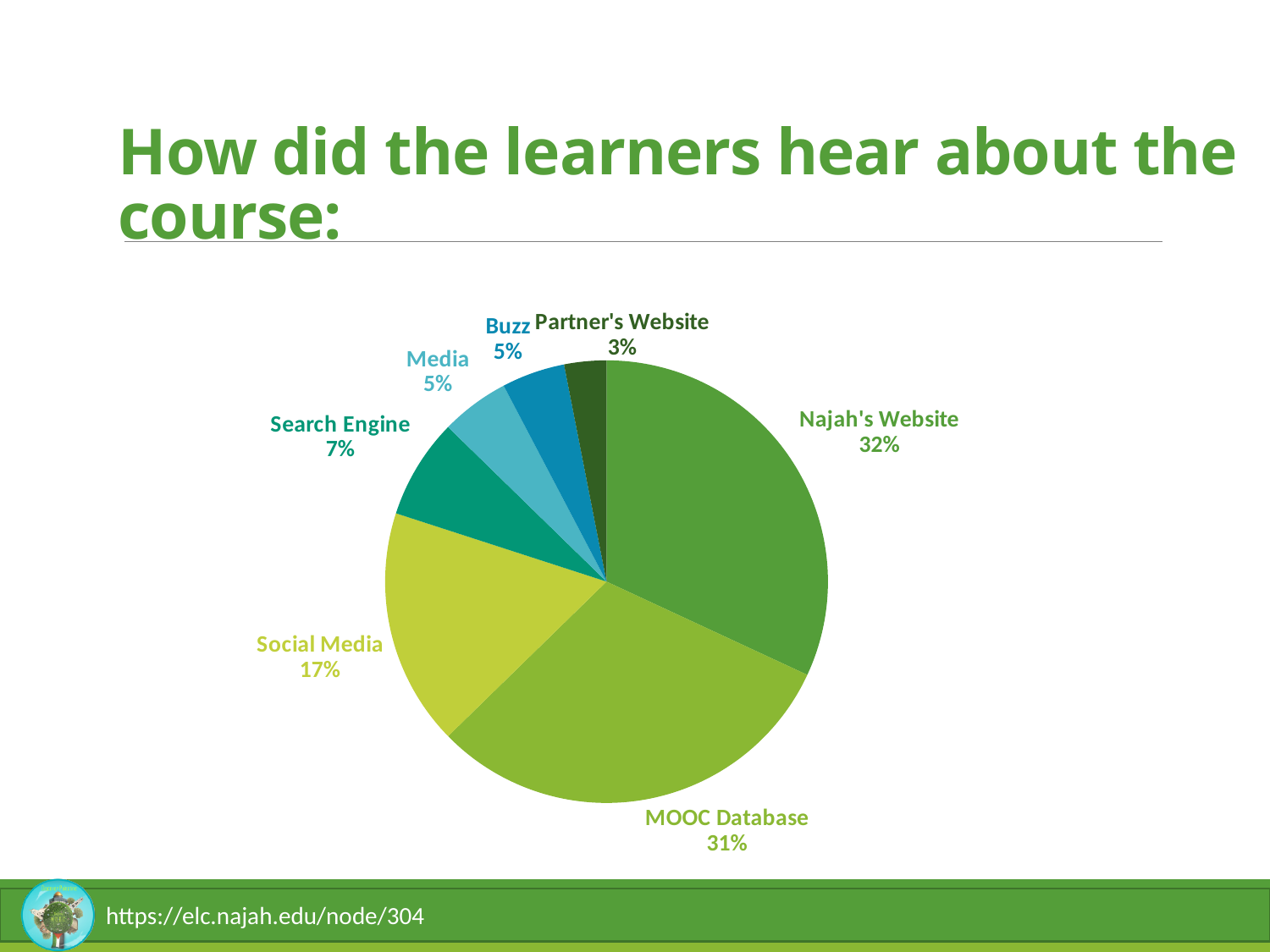
What share of learners heard about the course through Social Media? 17% What is the difference in percentage points between Social Media and Search Engine? 10 Which is larger, the share for Social Media or the share for Search Engine? Social Media How many categories are shown in the pie chart? 7 What share of learners heard about the course through Najah's Website? 32% What percentage is shown for Partner's Website? 3% What is the title of the slide containing the chart? How did the learners hear about the course: Which source has the largest share of the pie? Najah's Website What percentage of learners heard about the course through the MOOC Database? 31% What percentage is shown for Search Engine? 7% What type of chart is shown on the slide? Pie chart Which source has the smallest share of the pie? Partner's Website